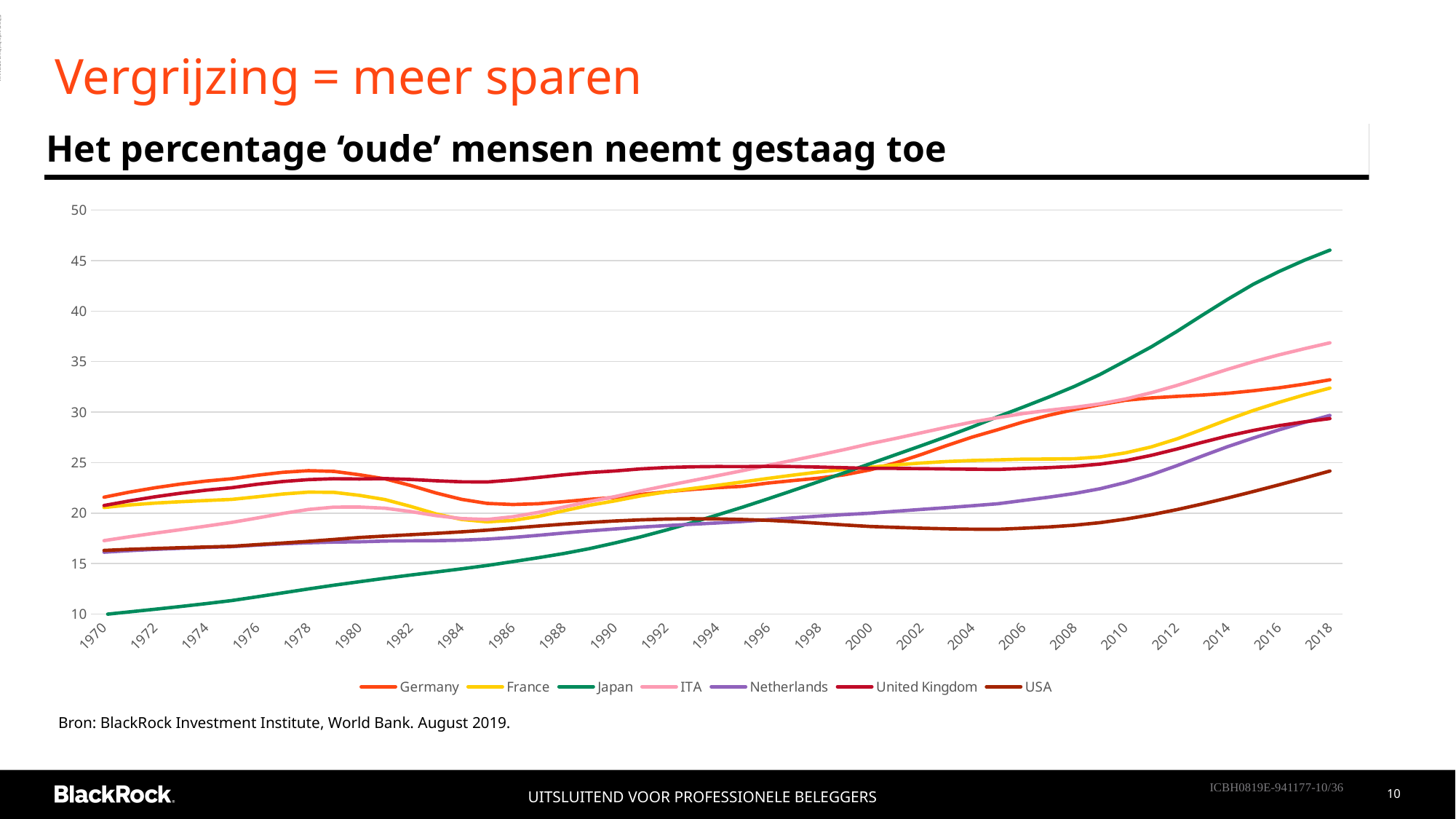
Is the value for ITA in 2018 greater or less than 35? greater Which country has the highest value in 2018? Japan Which country has the lowest value in 1970? Japan Does the line for Japan rise or fall from 1970 to 2018? rise Which is larger in 2018, the value for Japan or the value for USA? Japan Which country has the lowest value in 2018? USA Is the value for USA in 2018 greater or less than 25? less How many series does the legend list? 7 What kind of chart is shown on the slide? line chart Is the value for Japan in 2018 greater or less than 45? greater What is the title shown above the chart? Het percentage ‘oude’ mensen neemt gestaag toe